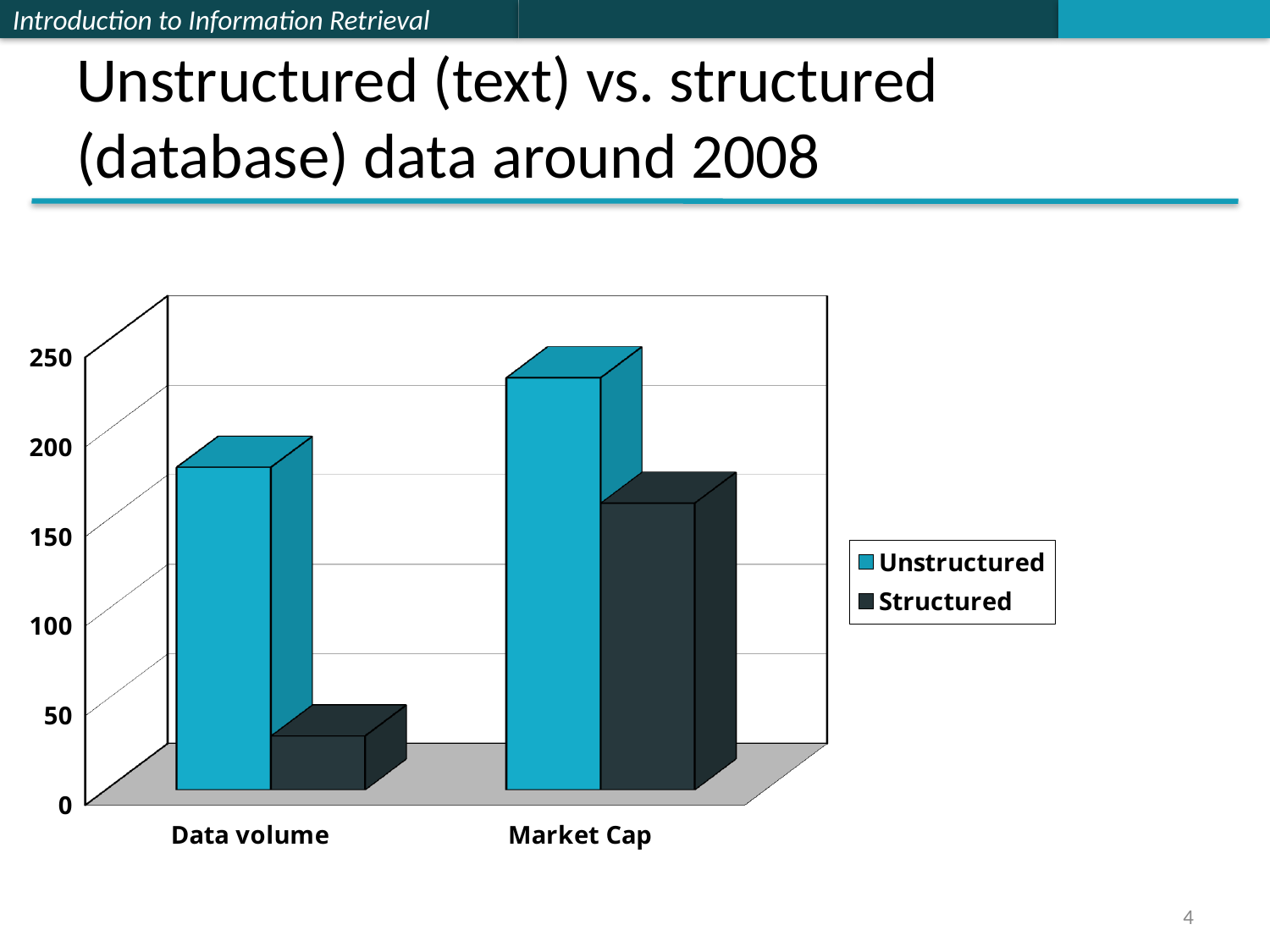
For Market Cap, which is larger, Unstructured or Structured? Unstructured Is the Structured value for Market Cap greater or less than 100? greater What kind of chart is shown on the slide? bar chart For Data volume, which is larger, Unstructured or Structured? Unstructured Is the Unstructured value for Market Cap greater or less than 200? greater How many categories are shown on the x axis of the chart? 2 Which series are listed in the chart's legend? Unstructured and Structured Is the Unstructured value for Data volume greater or less than 150? greater Which category has the taller Unstructured bar, Data volume or Market Cap? Market Cap How many series does the chart's legend list? 2 Which bar in the chart is the lowest? Structured for Data volume